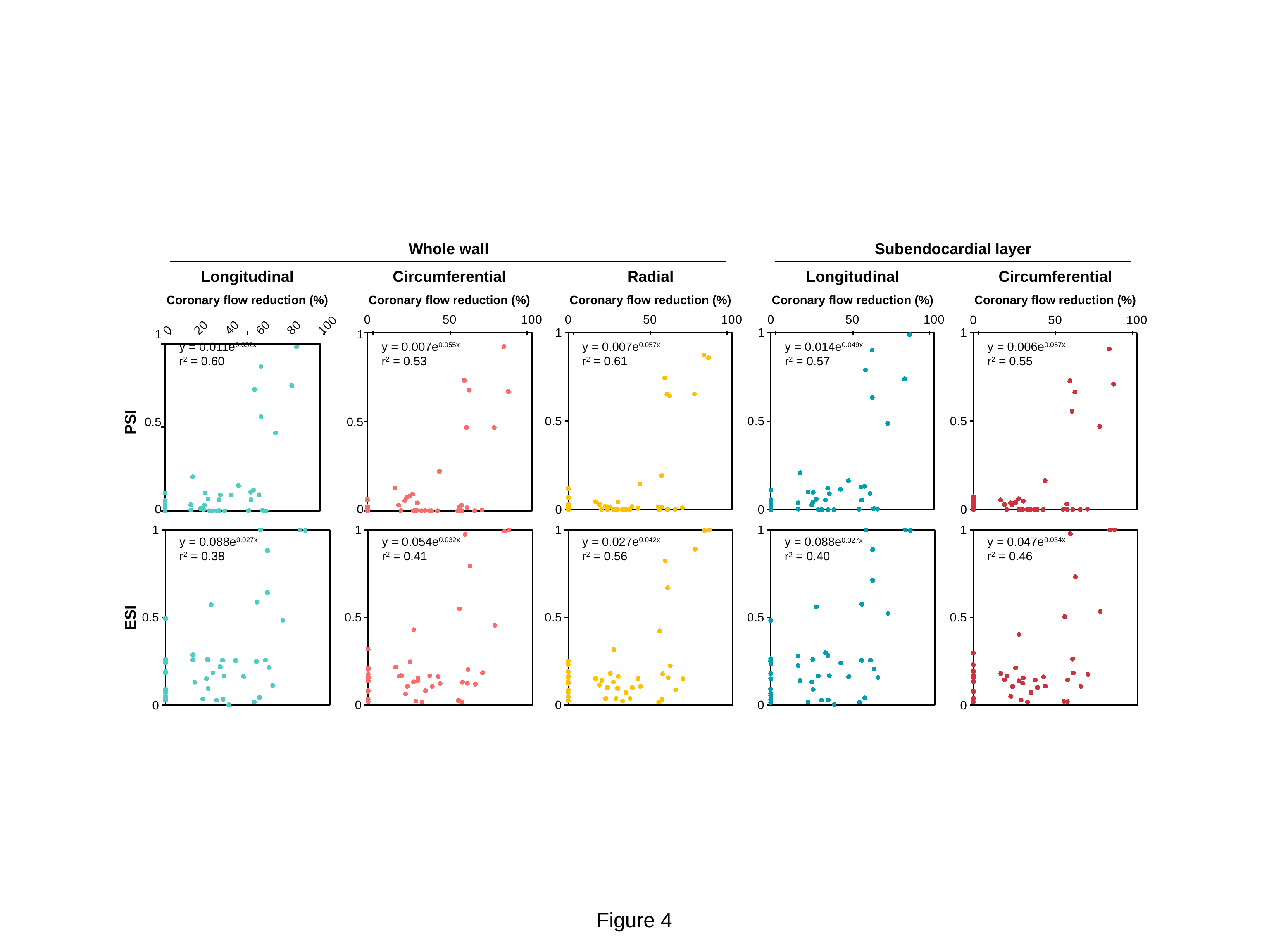
Among the PSI charts in the top row, which one shows the highest r² value? Whole wall Radial (r² = 0.61) In the Whole wall Circumferential PSI chart, is the highest plotted point greater or less than 0.5? greater What kind of chart is used in each panel of the figure? Scatter plot What is the x-axis label shared by all the charts? Coronary flow reduction (%) Among the ESI charts in the bottom row, which one shows the lowest r² value? Whole wall Longitudinal (r² = 0.38) In the Subendocardial layer Circumferential ESI chart, what fitted equation is shown? y = 0.047e^0.034x In the Whole wall Longitudinal PSI chart, what is the r² value? 0.60 What is the difference between the r² of the Whole wall Radial PSI chart and the Whole wall Radial ESI chart? 0.05 In the Whole wall Radial ESI chart, what is the r² value? 0.56 In the Subendocardial layer PSI charts, which has the larger r²: Longitudinal or Circumferential? Longitudinal How many scatter plots are shown on the slide? 10 In the Whole wall Longitudinal PSI chart, do the PSI values generally rise or fall as coronary flow reduction increases? Rise